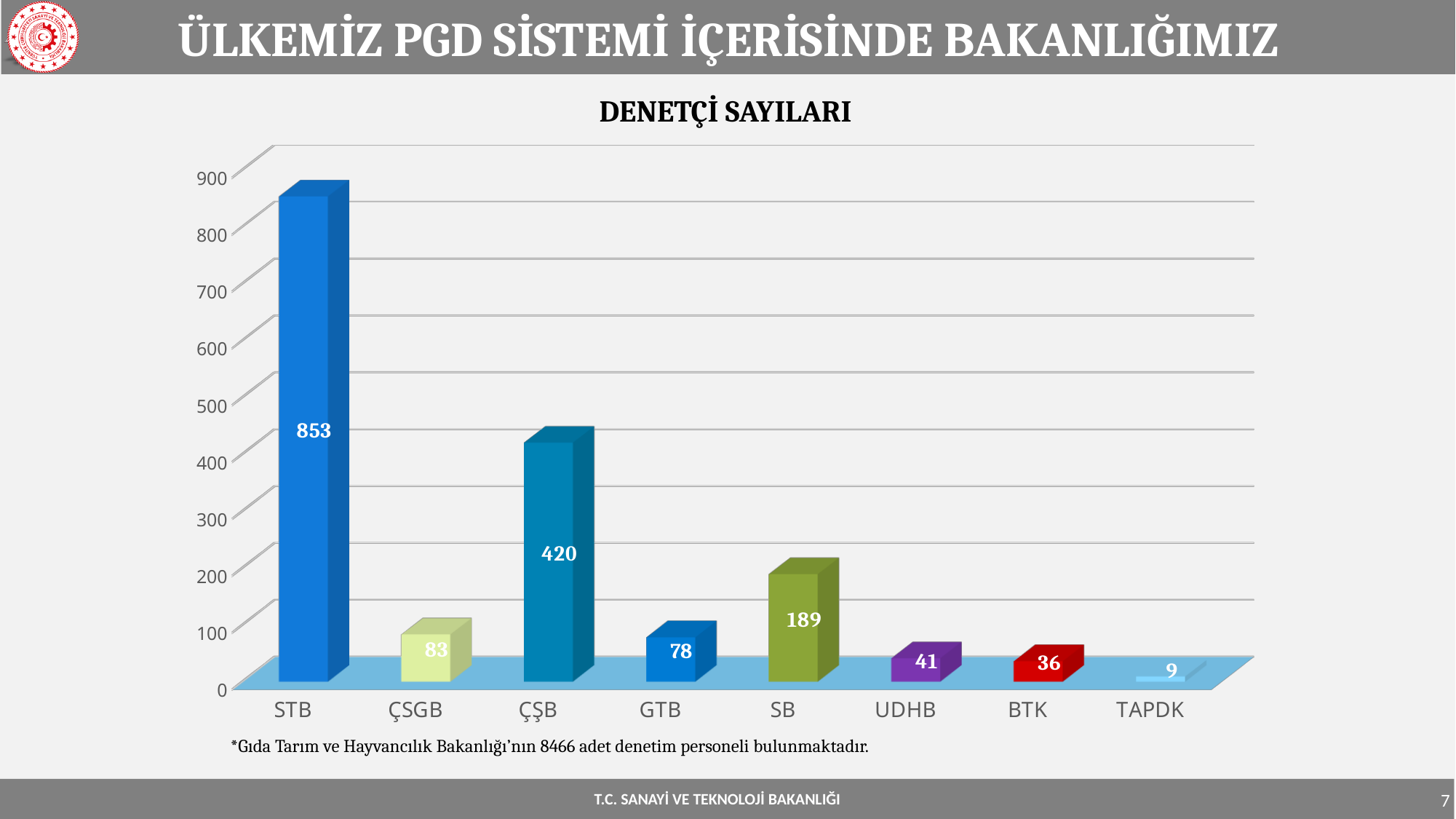
What is the difference between the values for ÇSGB and GTB in the DENETÇİ SAYILARI chart? 5 Which category has the lowest value in the DENETÇİ SAYILARI chart? TAPDK What is the value for STB in the DENETÇİ SAYILARI chart? 853 Which is larger in the DENETÇİ SAYILARI chart, the value for UDHB or the value for BTK? UDHB What is the value for SB in the DENETÇİ SAYILARI chart? 189 What is the value for TAPDK in the DENETÇİ SAYILARI chart? 9 Which category has the highest value in the DENETÇİ SAYILARI chart? STB What kind of chart is the DENETÇİ SAYILARI chart? Bar chart What is the difference between the values for STB and ÇŞB in the DENETÇİ SAYILARI chart? 433 How many categories are shown on the x axis of the DENETÇİ SAYILARI chart? 8 What is the title of the chart on the slide? DENETÇİ SAYILARI What is the value for ÇŞB in the DENETÇİ SAYILARI chart? 420